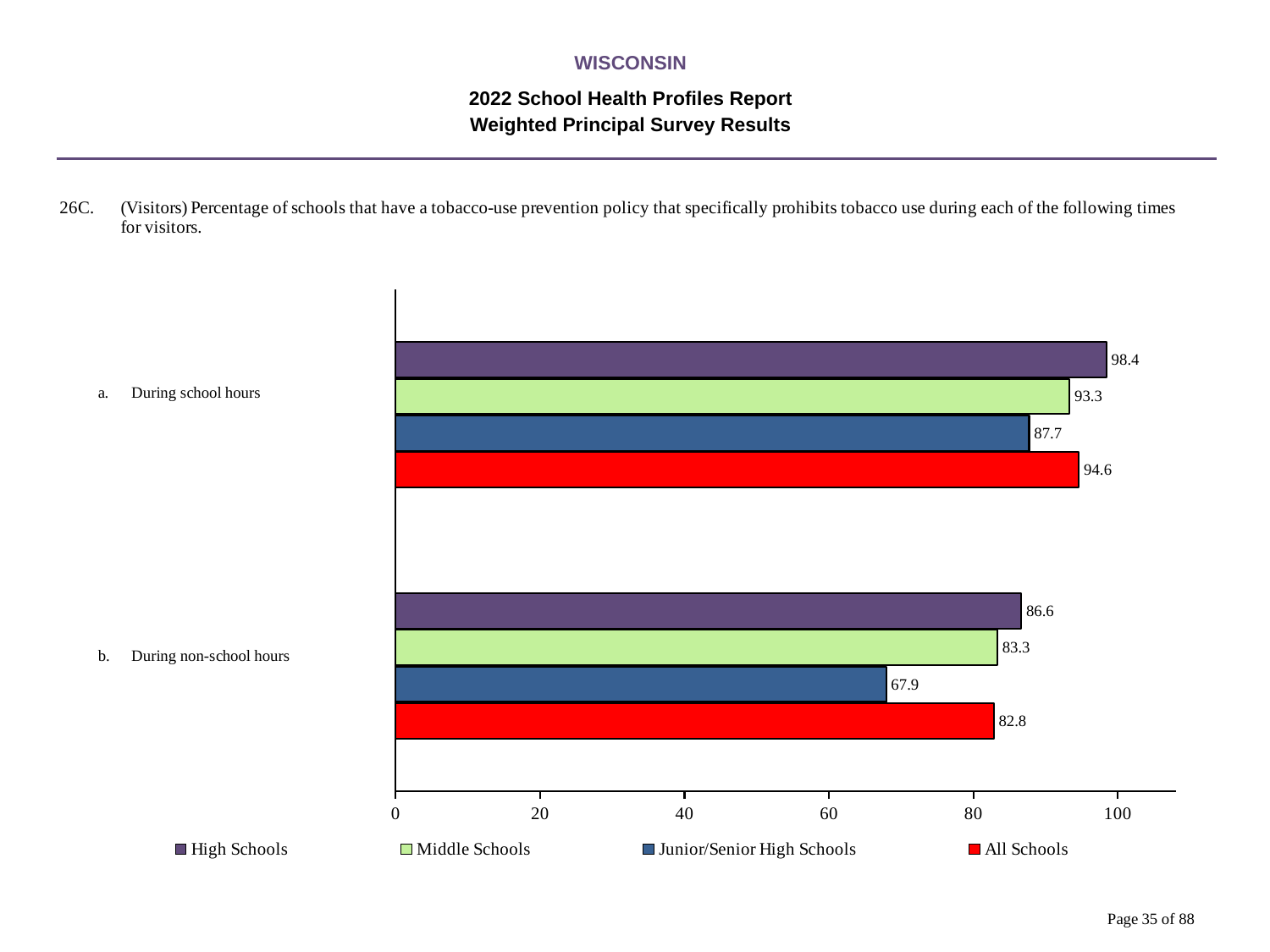
Which series has the highest value during school hours? High Schools What is the value for Junior/Senior High Schools during non-school hours? 67.9 Is the value for Junior/Senior High Schools during non-school hours greater or less than 80? less What is the value for Middle Schools during non-school hours? 83.3 What kind of chart is shown on the slide? bar chart What is the difference between the High Schools values for during school hours and during non-school hours? 11.8 What is the value for All Schools during school hours? 94.6 What colour represents All Schools in the chart? red What is the value for High Schools during school hours? 98.4 Which is larger: the Middle Schools value during school hours or the All Schools value during school hours? All Schools Which series has the lowest value during non-school hours? Junior/Senior High Schools How many series does the legend list? 4